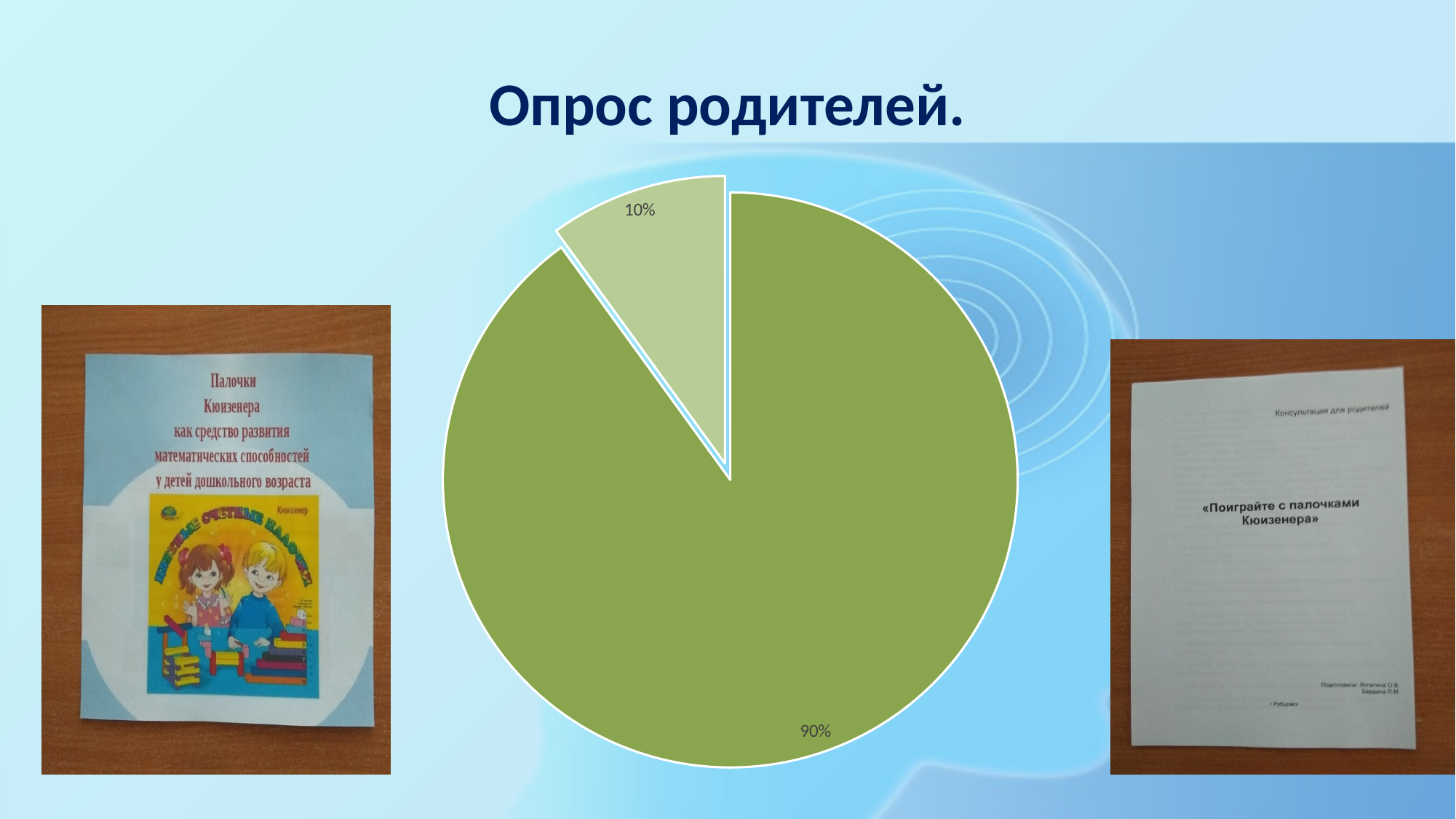
What is the difference between the two slices of the pie chart? 80% What kind of chart is shown on the slide? pie chart What is the largest value shown in the pie chart? 90% What is the title written above the pie chart on the slide? Опрос родителей. How many slices does the pie chart have? 2 What is the total of the two slices shown in the pie chart? 100% Which slice is larger, the darker green one or the lighter green one? the darker green one Does the pie chart have a legend? No What share of the pie does the larger, darker green slice represent? 90% What is the smallest value shown in the pie chart? 10% What share of the pie does the smaller, lighter green slice represent? 10% Is the value of the lighter green slice greater or less than 50%? less